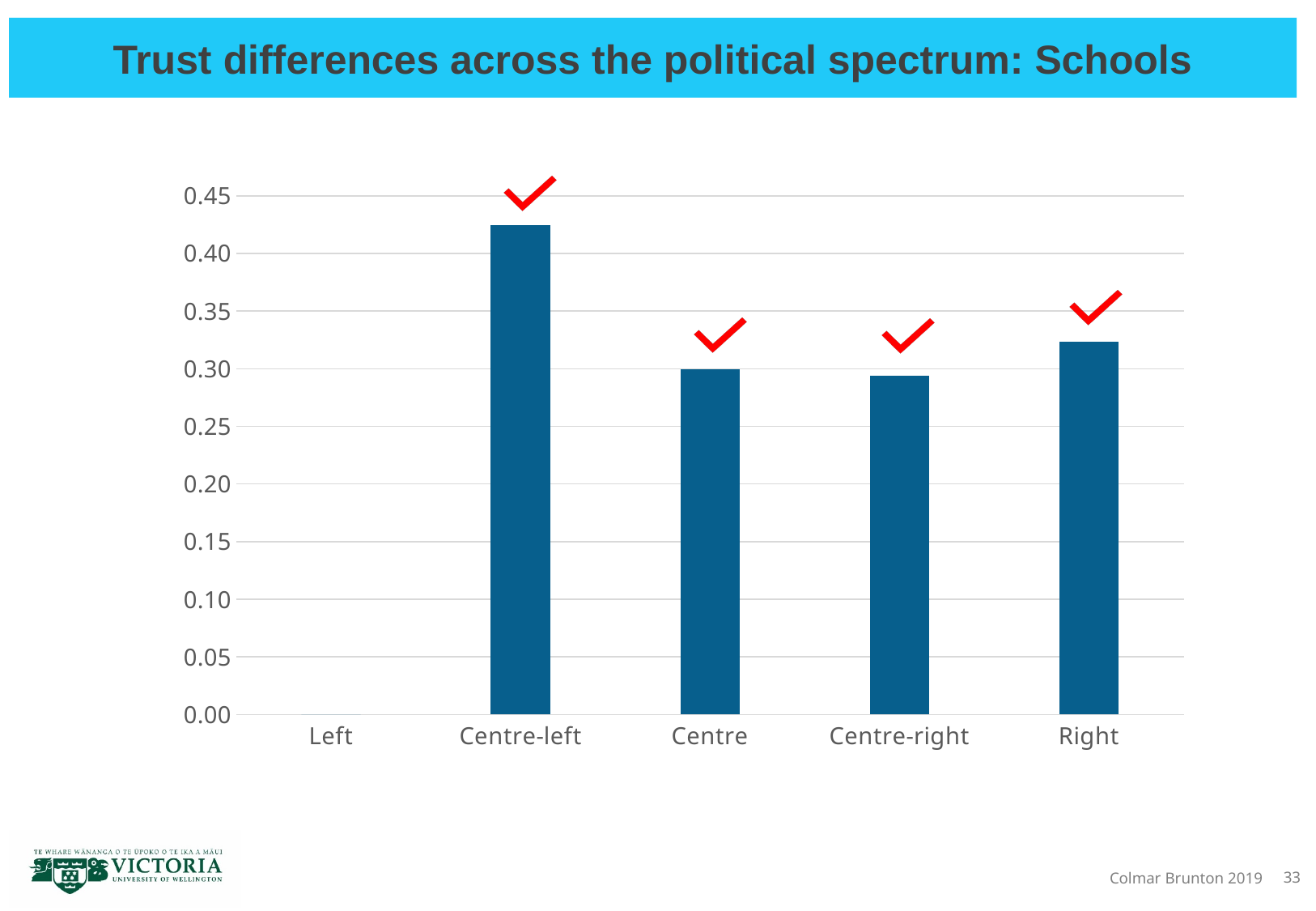
Is the value for Centre-left greater or less than 0.45? less Is the value for Right greater or less than 0.30? greater Which category on the x axis has no visible bar? Left Which category has the highest bar? Centre-left Is the value for Centre-left greater or less than 0.40? greater How many categories are shown on the x axis? 5 What kind of chart is shown on the slide? bar chart Which is larger, the value for Right or the value for Centre? Right Which is larger, the value for Centre-left or the value for Right? Centre-left What is the title of the chart? Trust differences across the political spectrum: Schools